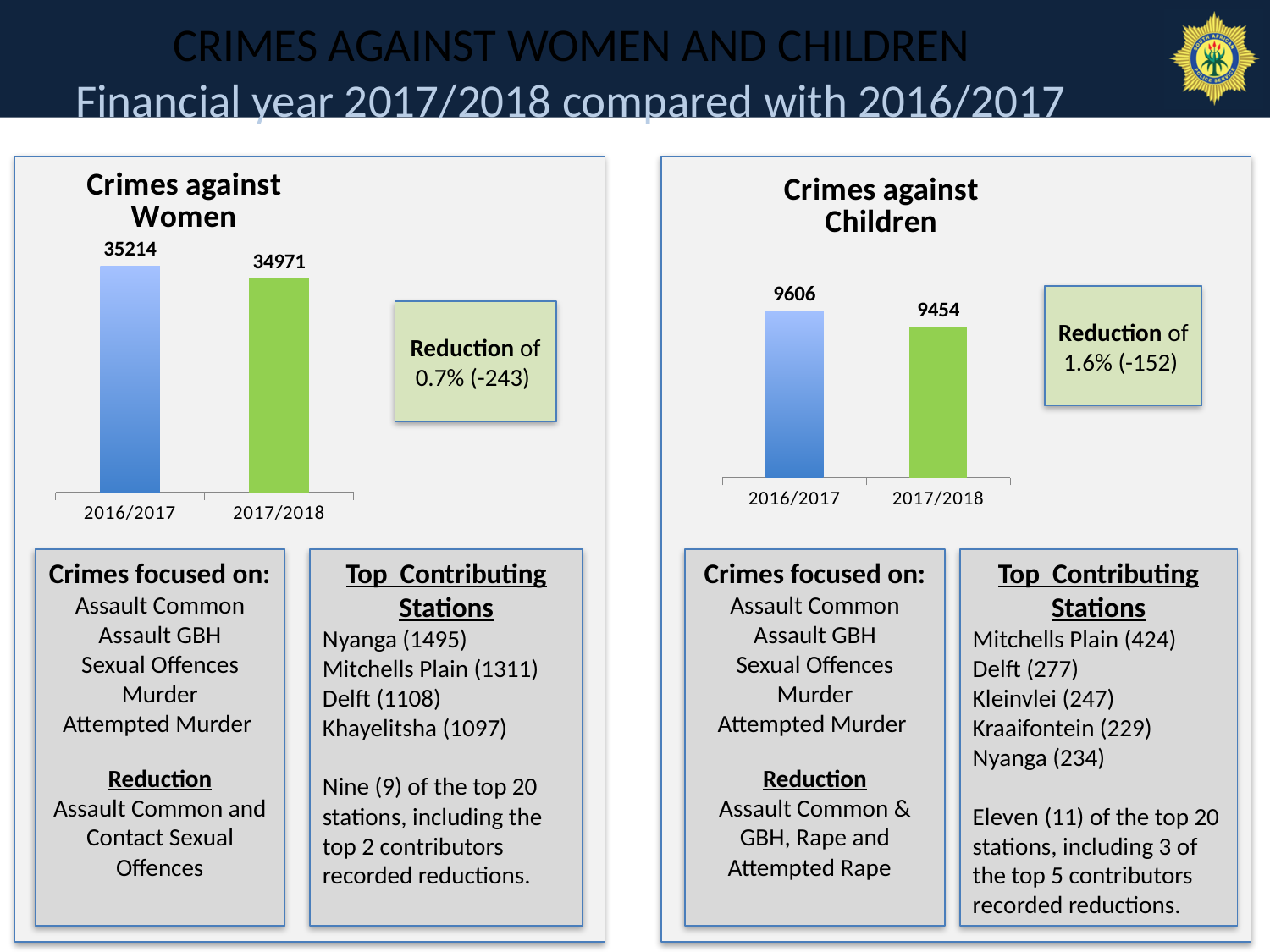
In the 'Crimes against Children' chart, what is the value for 2017/2018? 9454 What kind of chart is the 'Crimes against Women' chart? bar chart In the 'Crimes against Women' chart, what is the value for 2017/2018? 34971 In the 'Crimes against Women' chart, what is the difference between the 2016/2017 and 2017/2018 values? 243 In the 'Crimes against Children' chart, is the value for 2016/2017 larger or smaller than the value for 2017/2018? larger In the 'Crimes against Women' chart, what is the value for 2016/2017? 35214 In the 'Crimes against Women' chart, which year has the higher value? 2016/2017 How many categories are shown in the 'Crimes against Children' chart? 2 In the 'Crimes against Children' chart, which year has the lower value? 2017/2018 In the 'Crimes against Children' chart, what is the value for 2016/2017? 9606 In the 'Crimes against Women' chart, do the values rise or fall from 2016/2017 to 2017/2018? fall In the 'Crimes against Children' chart, what is the difference between the 2016/2017 and 2017/2018 values? 152